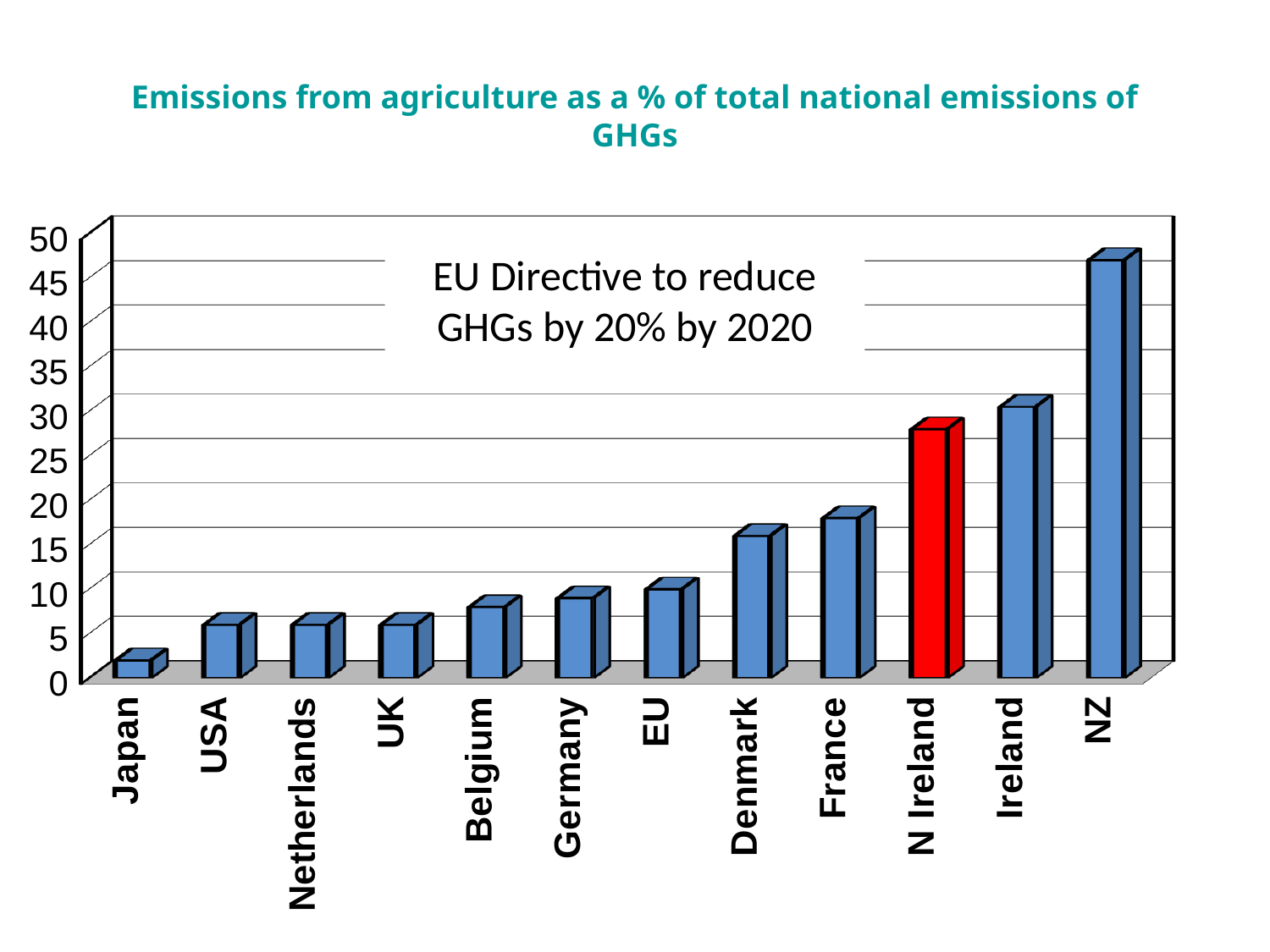
What kind of chart is shown on the slide? bar chart Is the value for Ireland greater or less than 25? greater Which country has the lowest emissions from agriculture as a % of total national emissions? Japan Is the value for EU greater or less than 15? less Which is larger, the value for Ireland or the value for N Ireland? Ireland Is the value for NZ greater or less than 40? greater Do the values generally rise or fall moving from left to right along the x axis? rise Which country's bar is coloured red in the chart? N Ireland How many countries or regions are shown on the x axis of the chart? 12 Which country has the highest emissions from agriculture as a % of total national emissions? NZ